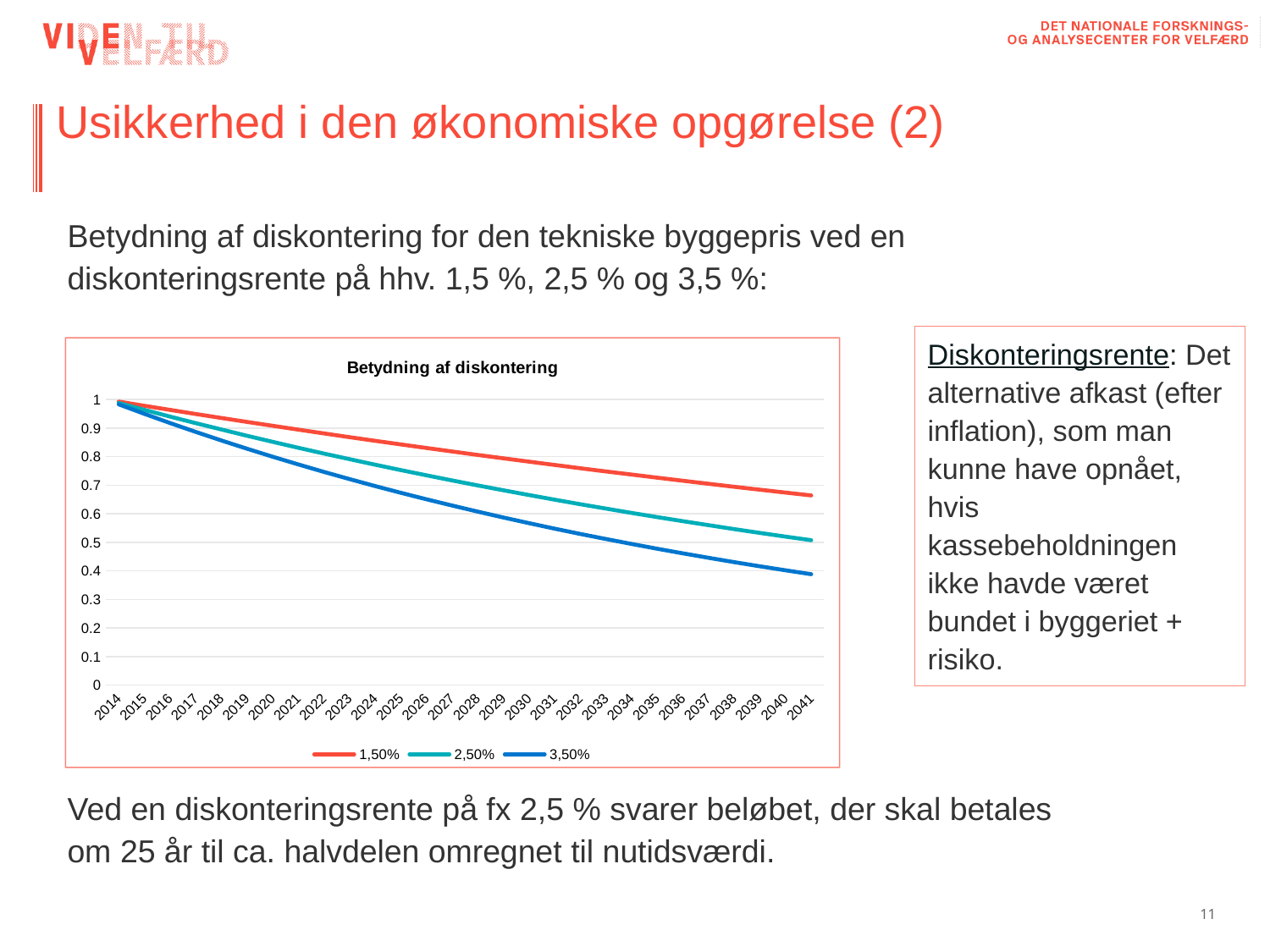
Is the value for the 1,50% series in 2041 greater or less than 0.6? greater What is the title of the chart? Betydning af diskontering How many years are shown along the x axis of the chart? 28 Which series has the lowest value in 2041? 3,50% Is the value for the 3,50% series in 2041 greater or less than 0.5? less Do the values of the 3,50% series rise or fall from 2014 to 2041? fall Which series has the highest value in 2041? 1,50% What are the series names listed in the chart legend? 1,50%, 2,50%, 3,50% In 2041, which series has the larger value, 1,50% or 3,50%? 1,50% What kind of chart is shown on the slide? line chart How many series does the chart legend list? 3